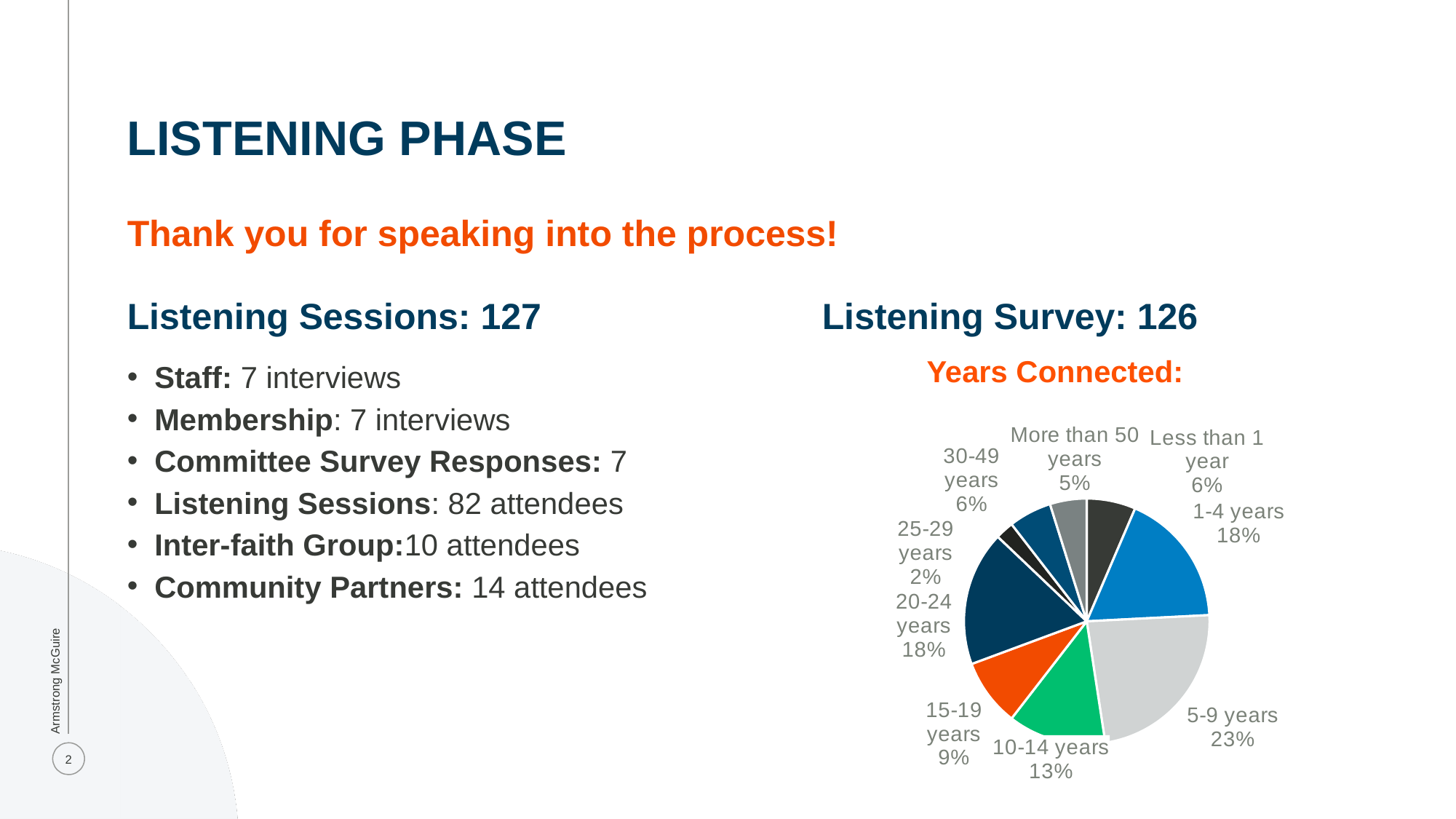
What share of the pie chart is the 5-9 years slice? 23% Which category has the largest slice in the pie chart? 5-9 years How many categories are shown in the pie chart? 9 Which category has the smallest slice in the pie chart? 25-29 years What kind of chart is shown under "Years Connected:"? pie chart What percentage is shown for More than 50 years in the pie chart? 5% Which is larger in the pie chart, the 1-4 years slice or the 10-14 years slice? 1-4 years What percentage is shown for 10-14 years in the pie chart? 13% What is the title of the pie chart? Years Connected: What is the difference in percentage points between the 5-9 years slice and the 15-19 years slice? 14 What percentage is shown for 25-29 years in the pie chart? 2% What is the combined percentage of the Less than 1 year and 1-4 years slices? 24%